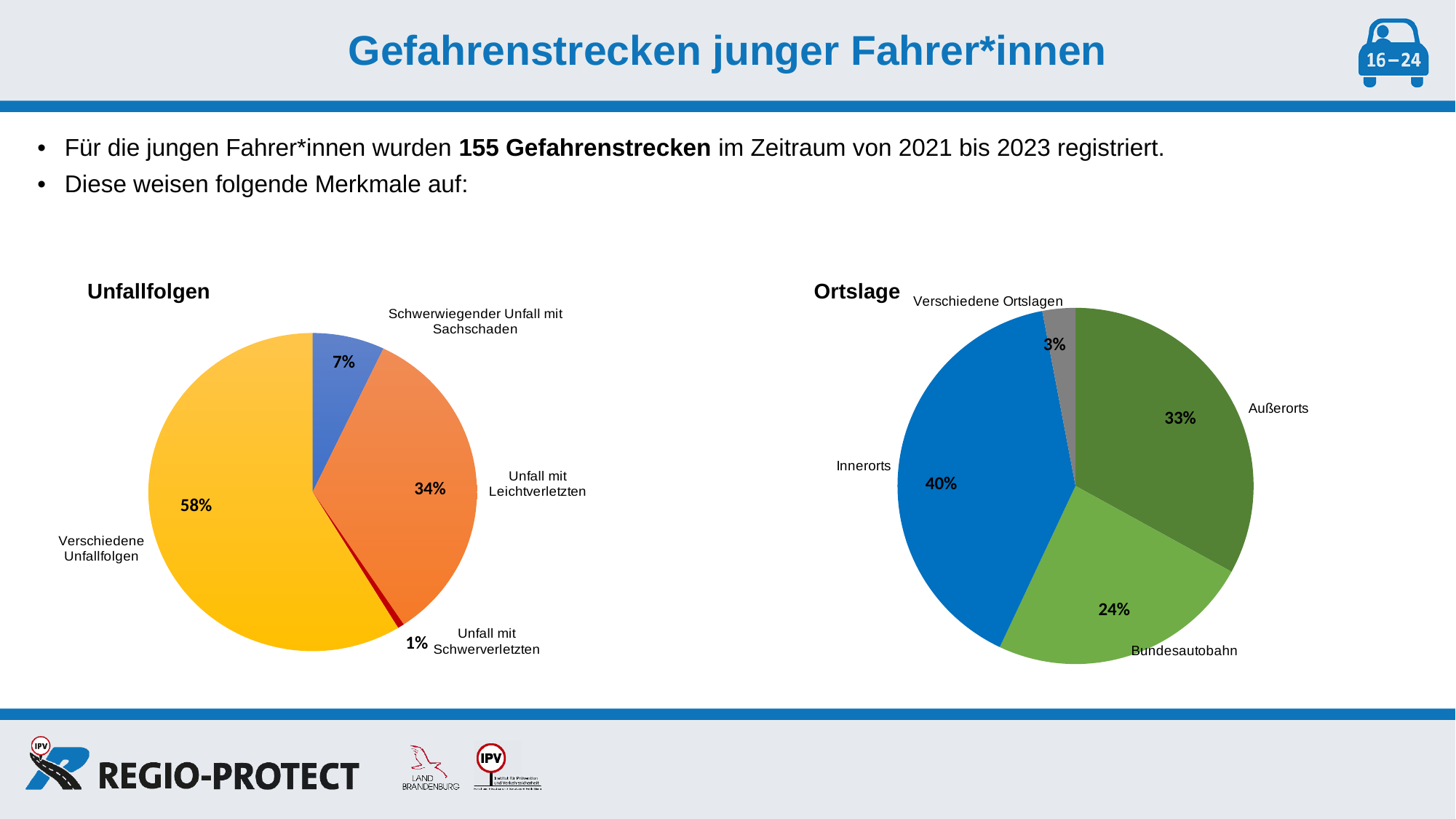
In the "Ortslage" chart, which category has the largest slice? Innerorts In the "Ortslage" chart, what is the difference in percentage points between "Innerorts" and "Außerorts"? 7 What type of chart is the "Ortslage" chart? Pie chart In the "Unfallfolgen" chart, what share is labelled for "Schwerwiegender Unfall mit Sachschaden"? 7% In the "Ortslage" chart, what share is labelled for "Bundesautobahn"? 24% In the "Unfallfolgen" chart, how many slices does the pie have? 4 In the "Unfallfolgen" chart, which category has the smallest slice? Unfall mit Schwerverletzten In the "Unfallfolgen" chart, which category has the largest slice? Verschiedene Unfallfolgen In the "Unfallfolgen" chart, what is the difference in percentage points between "Verschiedene Unfallfolgen" and "Unfall mit Leichtverletzten"? 24 In the "Unfallfolgen" chart, what share is labelled for "Unfall mit Leichtverletzten"? 34% In the "Ortslage" chart, which is larger, "Außerorts" or "Bundesautobahn"? Außerorts In the "Ortslage" chart, what share is labelled for "Verschiedene Ortslagen"? 3%